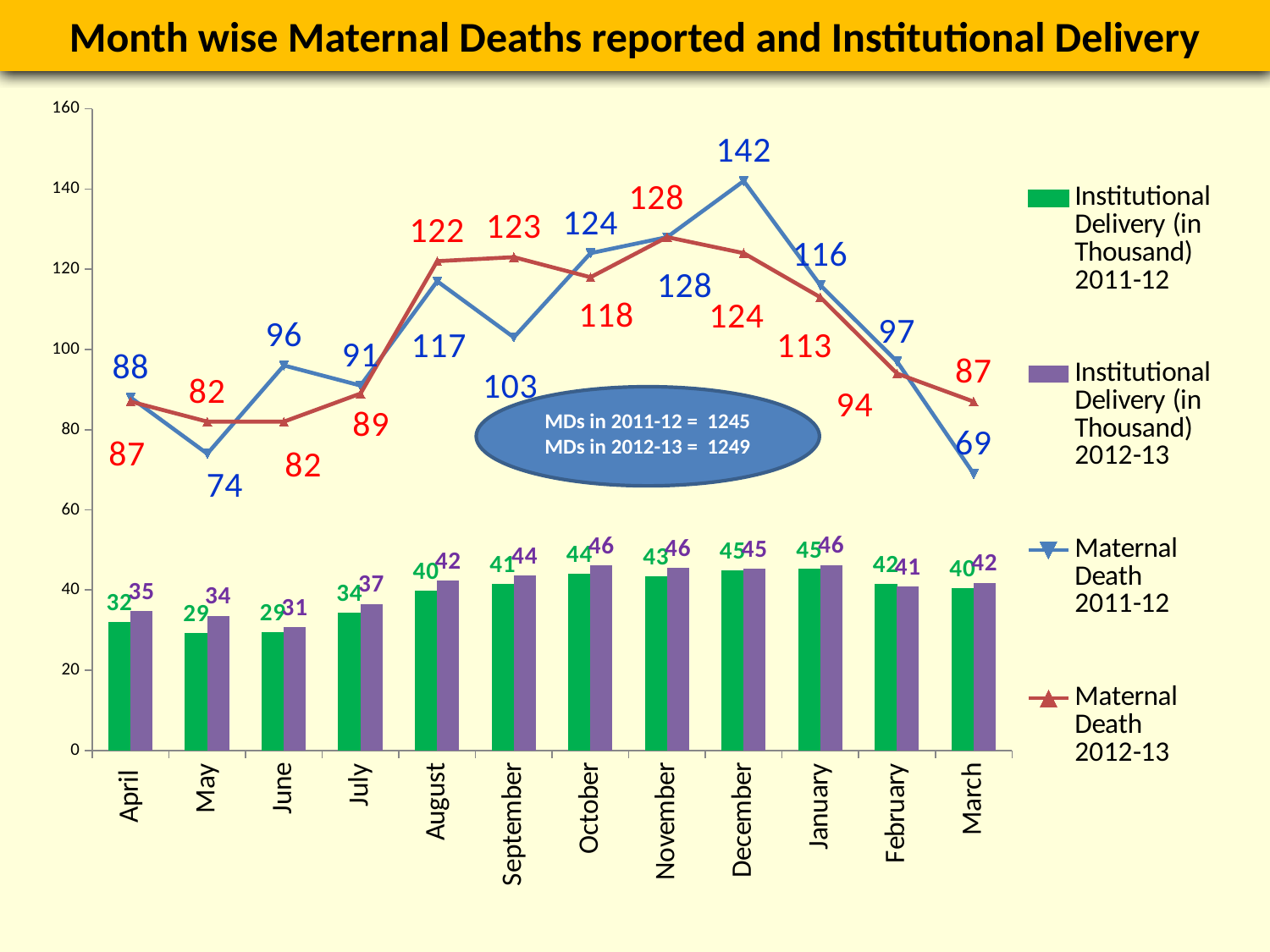
In which month was the Institutional Delivery (in Thousand) 2012-13 value lowest? June In which month was the Maternal Death 2011-12 value lowest? March What was the Institutional Delivery (in Thousand) 2012-13 value in October? 46 In which month was the Maternal Death 2011-12 value highest? December How many months are shown on the x axis? 12 What was the Maternal Death value for 2011-12 in December? 142 How many series does the legend list? 4 What kind of chart is shown on the slide? Combined bar and line chart In May, which series had the higher Maternal Death value, 2011-12 or 2012-13? 2012-13 What was the Maternal Death value for 2012-13 in August? 122 According to the callout on the chart, what was the total of MDs in 2012-13? 1249 What is the difference between the Maternal Death 2011-12 and 2012-13 values in December? 18